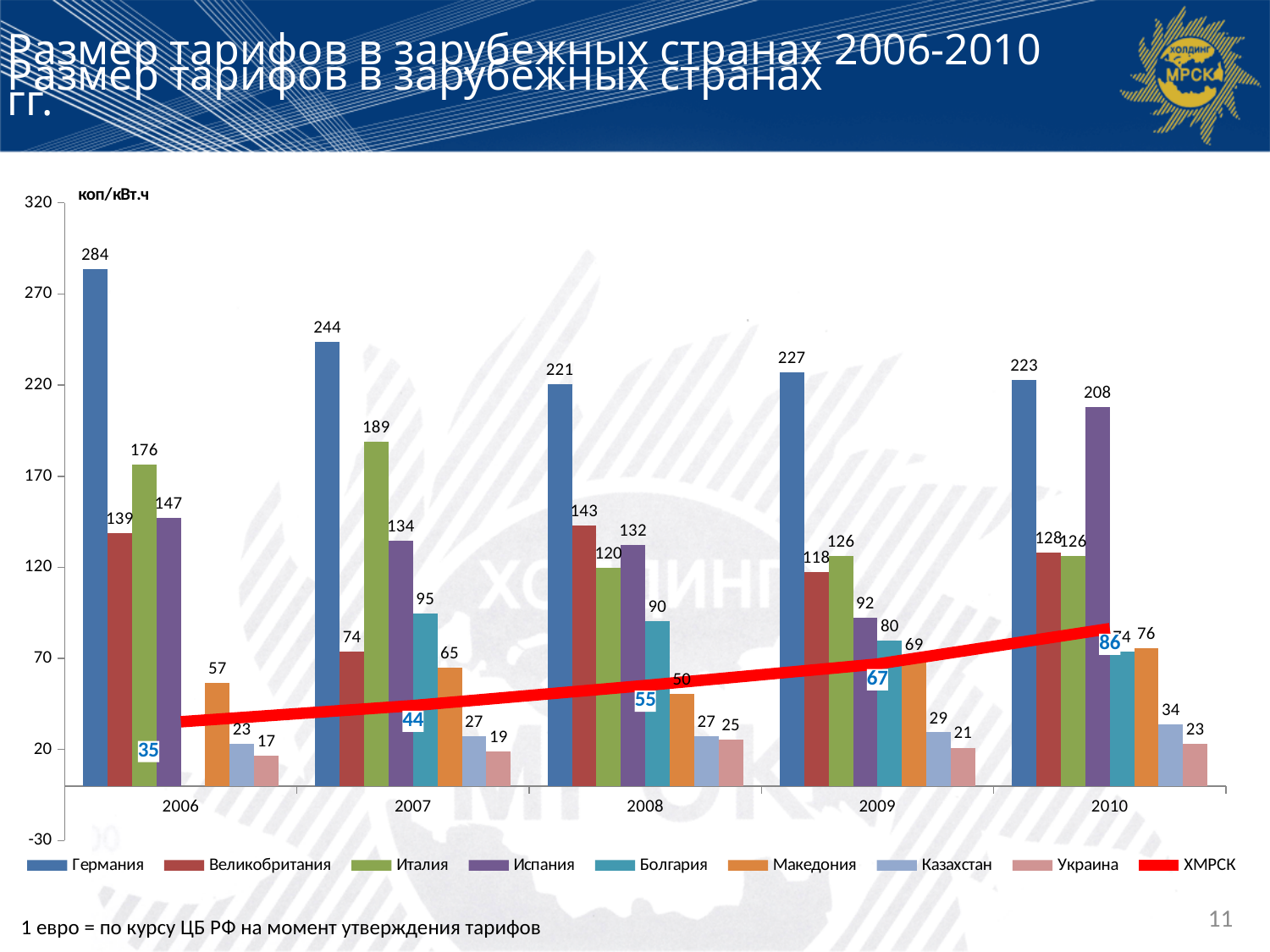
What is the value for Германия in 2006? 284 What is the value for Македония in 2009? 69 How many years are shown on the x axis? 5 Which country has the highest tariff in 2007? Германия Does the ХМРСК line rise or fall from 2006 to 2010? Rises What is the difference between the Германия values in 2006 and 2010? 61 Which is larger in 2010: the value for Германия or the value for Испания? Германия Which country has the lowest tariff in 2006? Украина What is the value of the ХМРСК line in 2008? 55 How many series does the legend list? 9 What is the value for Испания in 2010? 208 What kind of chart is shown on the slide? Bar chart with a line